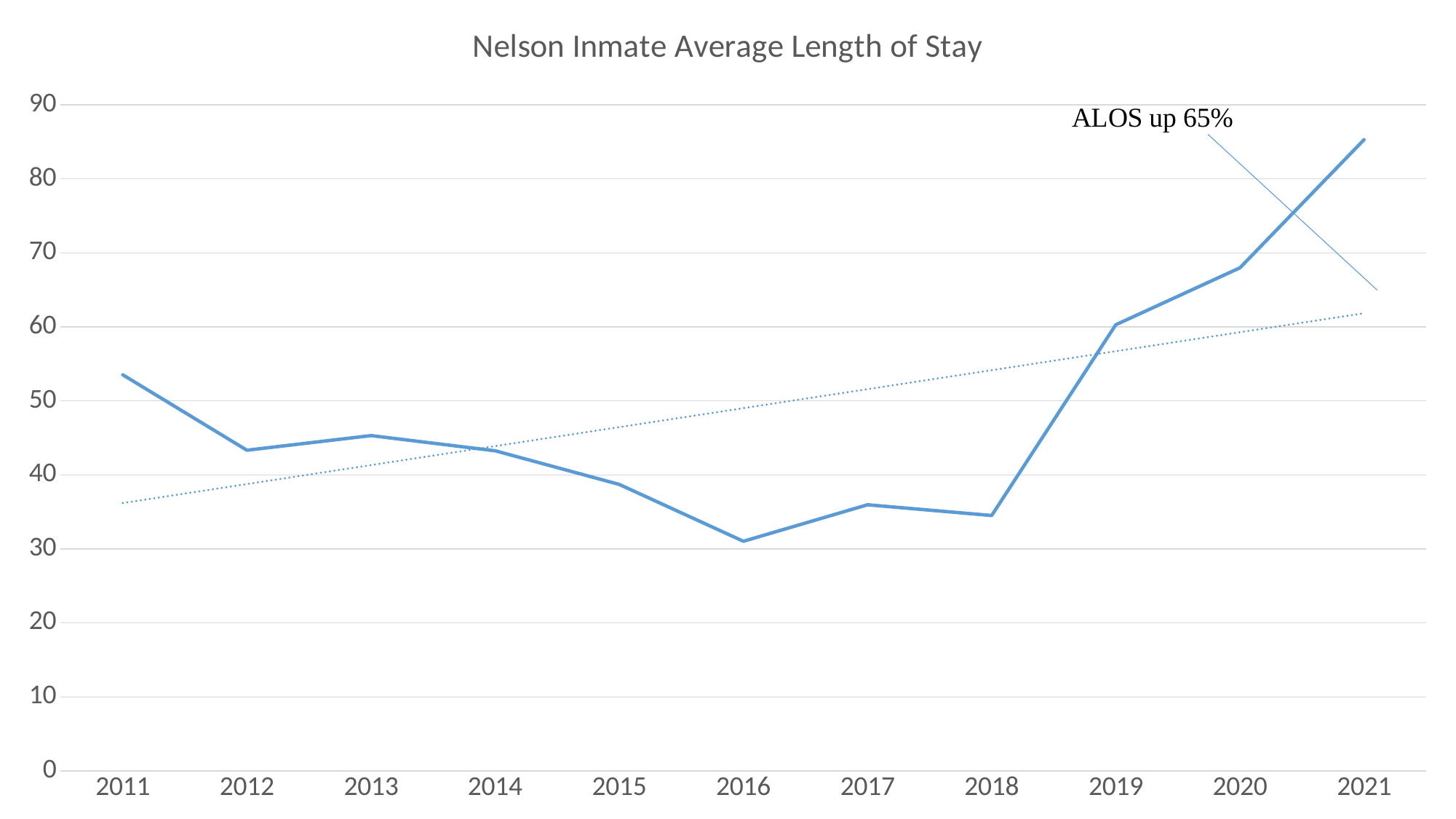
Is the value for 2011 greater or less than 50? greater Do the values rise or fall from 2018 to 2021? rise How many years are plotted along the x axis? 11 Which year has the lowest average length of stay? 2016 Which year has the larger value, 2011 or 2012? 2011 What kind of chart is shown on the slide? line chart What is the title of the chart? Nelson Inmate Average Length of Stay What does the annotation text on the chart say? ALOS up 65% Is the value for 2016 greater or less than 40? less Is the value for 2021 greater or less than 80? greater Which year has the highest average length of stay? 2021